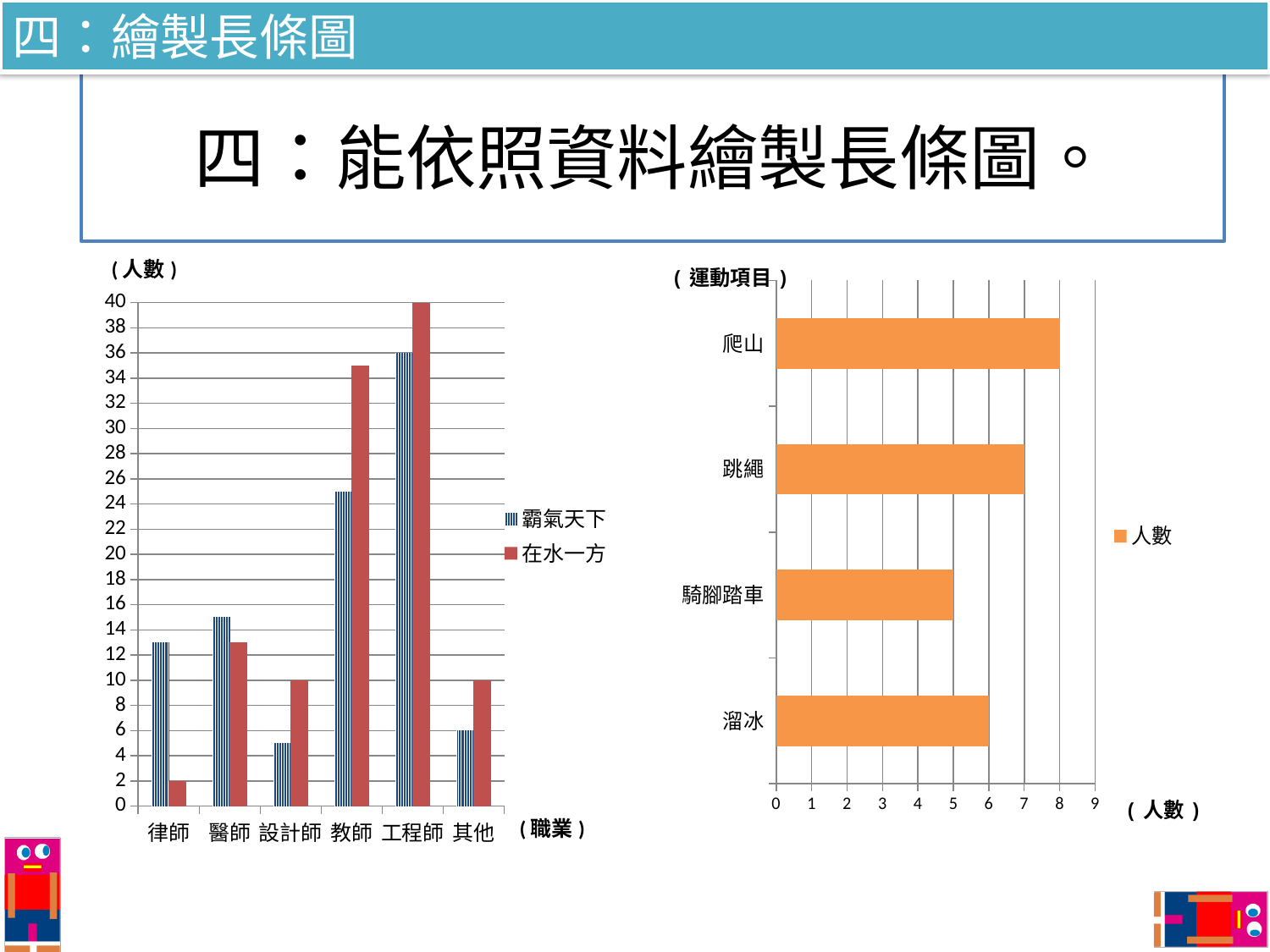
What kind of chart is the right chart (運動項目)? Bar chart In the right chart (運動項目), which activity has the lowest value? 騎腳踏車 In the left chart (職業), what is the value for 工程師 in the 在水一方 series? 40 In the left chart (職業), how many occupation categories are shown on the x axis? 6 In the left chart (職業), which is larger for 醫師: 霸氣天下 or 在水一方? 霸氣天下 In the left chart (職業), which occupation has the highest value in the 霸氣天下 series? 工程師 In the right chart (運動項目), what is the difference between the values for 跳繩 and 溜冰? 1 In the left chart (職業), how many series does the legend list? 2 In the left chart (職業), which occupation has the lowest value in the 在水一方 series? 律師 In the right chart (運動項目), what is the value for 爬山? 8